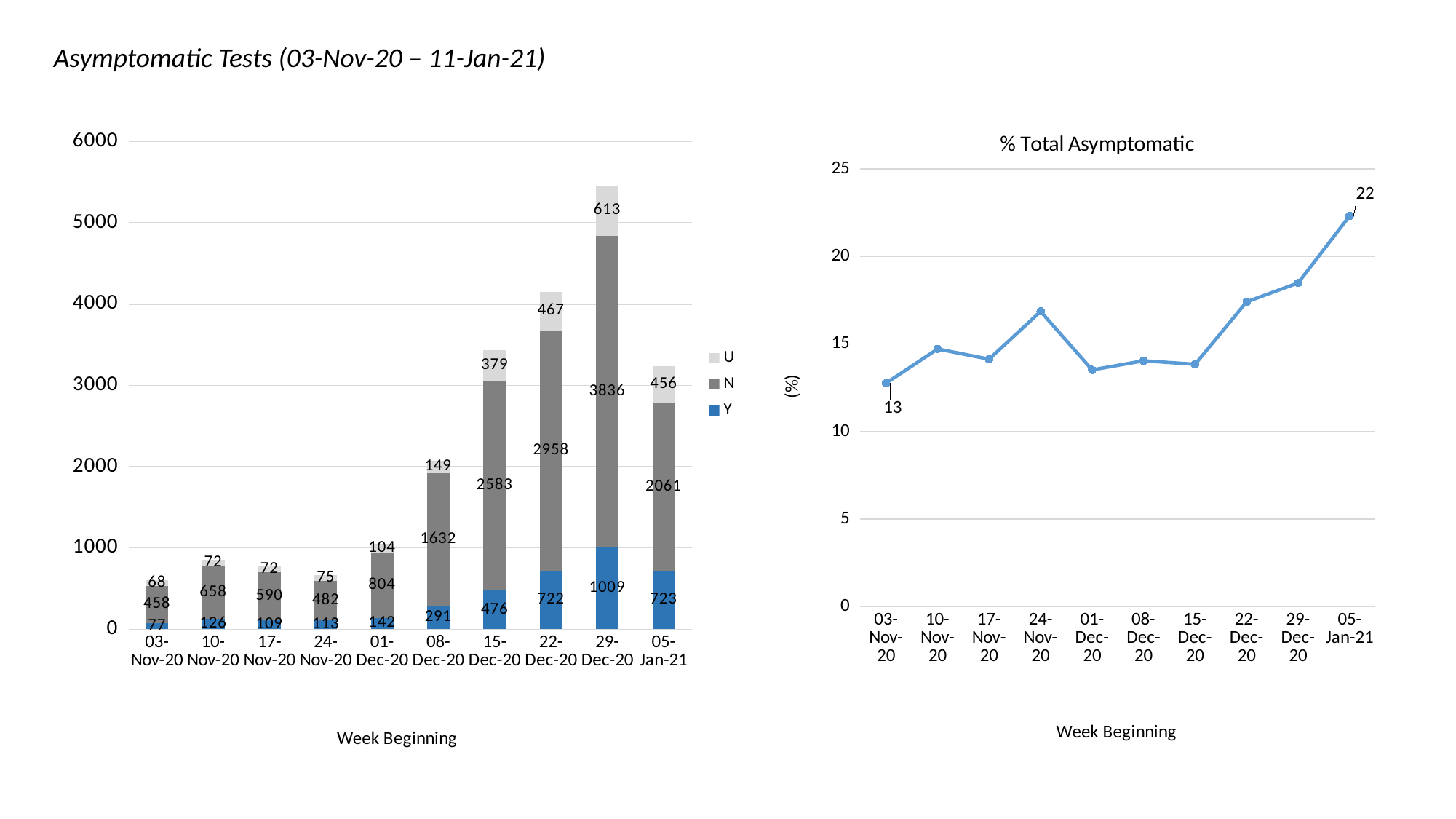
In the '% Total Asymptomatic' chart on the right, is the value for 24-Nov-20 greater or less than 15? greater In the stacked bar chart on the left, how many weeks are shown on the x axis? 10 In the stacked bar chart on the left, what is the value of the U series for the week beginning 22-Dec-20? 467 In the stacked bar chart on the left, which week has the lowest value for the N series? 03-Nov-20 In the stacked bar chart on the left, what is the value of the N series for the week beginning 29-Dec-20? 3836 In the stacked bar chart on the left, what is the value of the Y series for the week beginning 15-Dec-20? 476 In the stacked bar chart on the left, what is the difference between the N values for 22-Dec-20 and 15-Dec-20? 375 In the stacked bar chart on the left, which week has the highest value for the Y series? 29-Dec-20 In the '% Total Asymptomatic' chart on the right, what is the value for the week beginning 05-Jan-21? 22 In the stacked bar chart on the left, how many series does the legend list? 3 In the stacked bar chart on the left, what is the total of the stacked bar for the week beginning 29-Dec-20? 5458 What kind of chart is the '% Total Asymptomatic' chart on the right? line chart